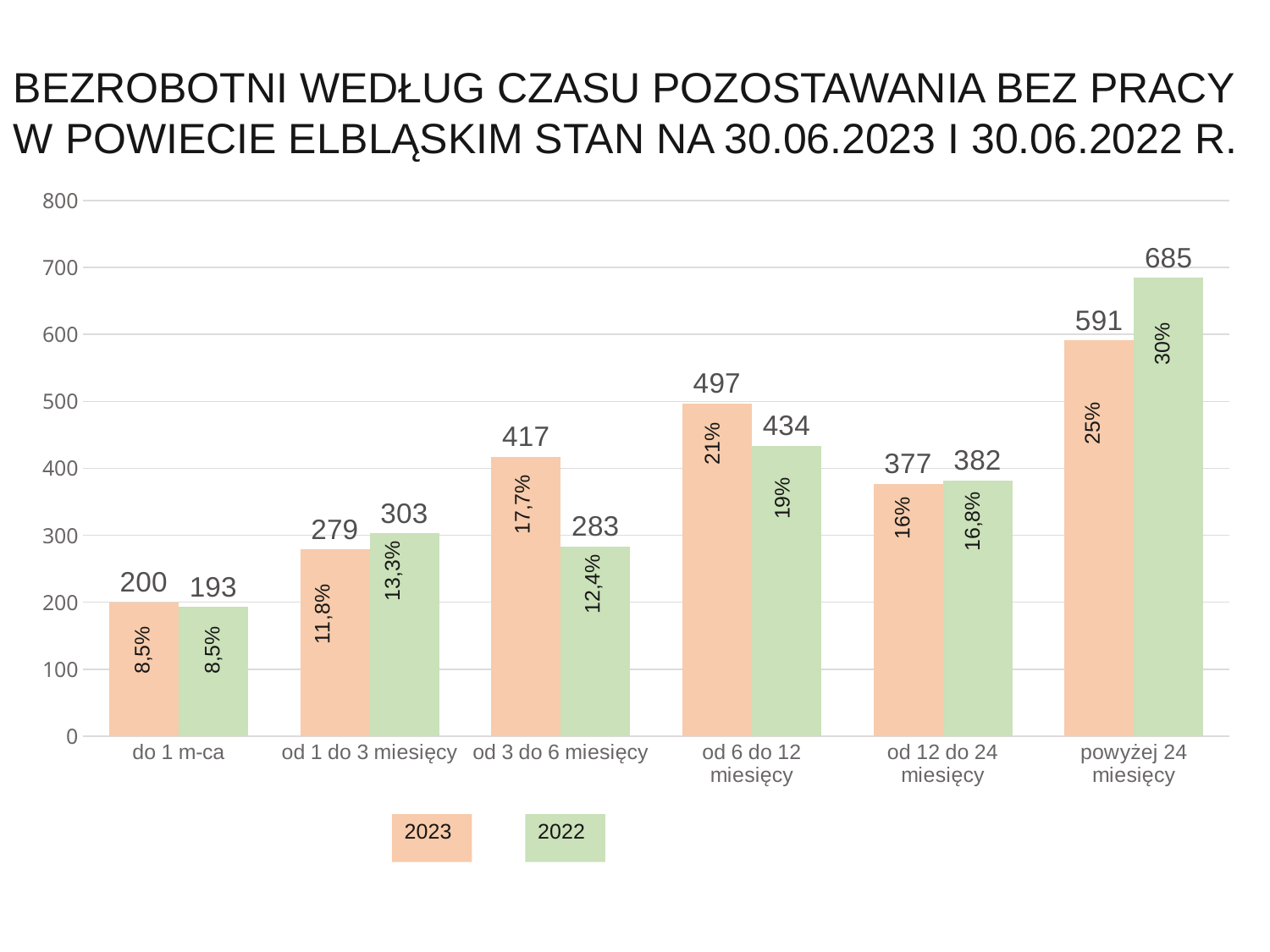
What is the value for 2023 in the 'od 6 do 12 miesięcy' category? 497 How many series does the legend list? 2 What percentage label is shown on the 2022 bar for 'od 1 do 3 miesięcy'? 13,3% What is the difference between the 2023 and 2022 values in the 'od 3 do 6 miesięcy' category? 134 In the 'od 1 do 3 miesięcy' category, which series has the larger value, 2023 or 2022? 2022 What kind of chart is shown on the slide? bar chart What is the difference between the 2022 and 2023 values in the 'powyżej 24 miesięcy' category? 94 Which colour represents the 2022 series in the legend? green What is the value for 2022 in the 'powyżej 24 miesięcy' category? 685 How many categories are shown on the x axis? 6 Which category has the highest value for the 2023 series? powyżej 24 miesięcy Which category has the lowest value for the 2022 series? do 1 m-ca